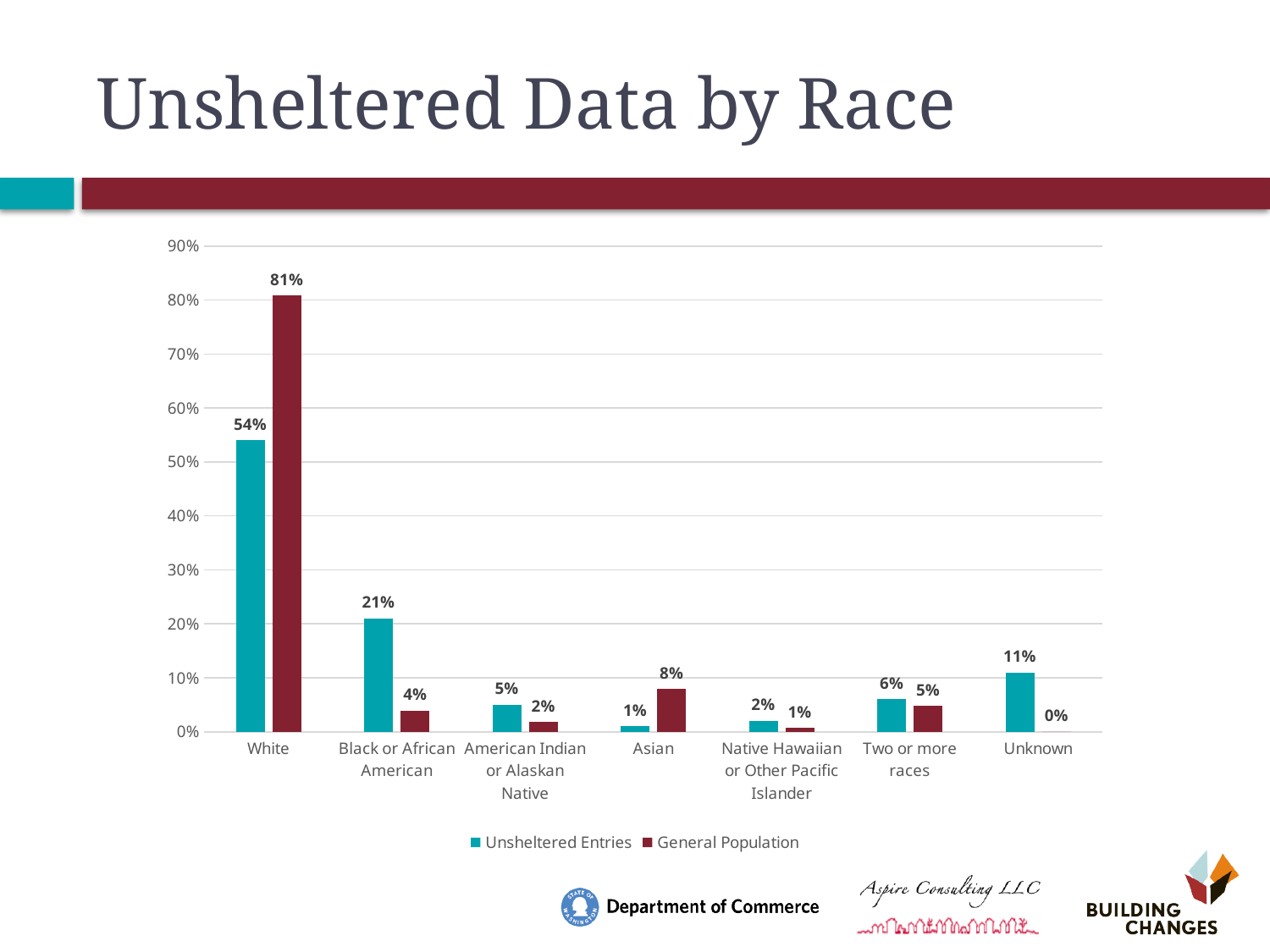
What is the Unsheltered Entries value for Black or African American? 21% What is the General Population value for White? 81% What kind of chart is shown on the slide? Bar chart What is the difference between the General Population and Unsheltered Entries values for White? 27% Which is larger for Black or African American: Unsheltered Entries or General Population? Unsheltered Entries Which category has the lowest Unsheltered Entries value? Asian How many race categories are shown on the x axis? 7 What is the Unsheltered Entries value for White? 54% How many series does the legend list? 2 Which category has the highest Unsheltered Entries value? White What is the General Population value for Unknown? 0% What is the title of the slide? Unsheltered Data by Race